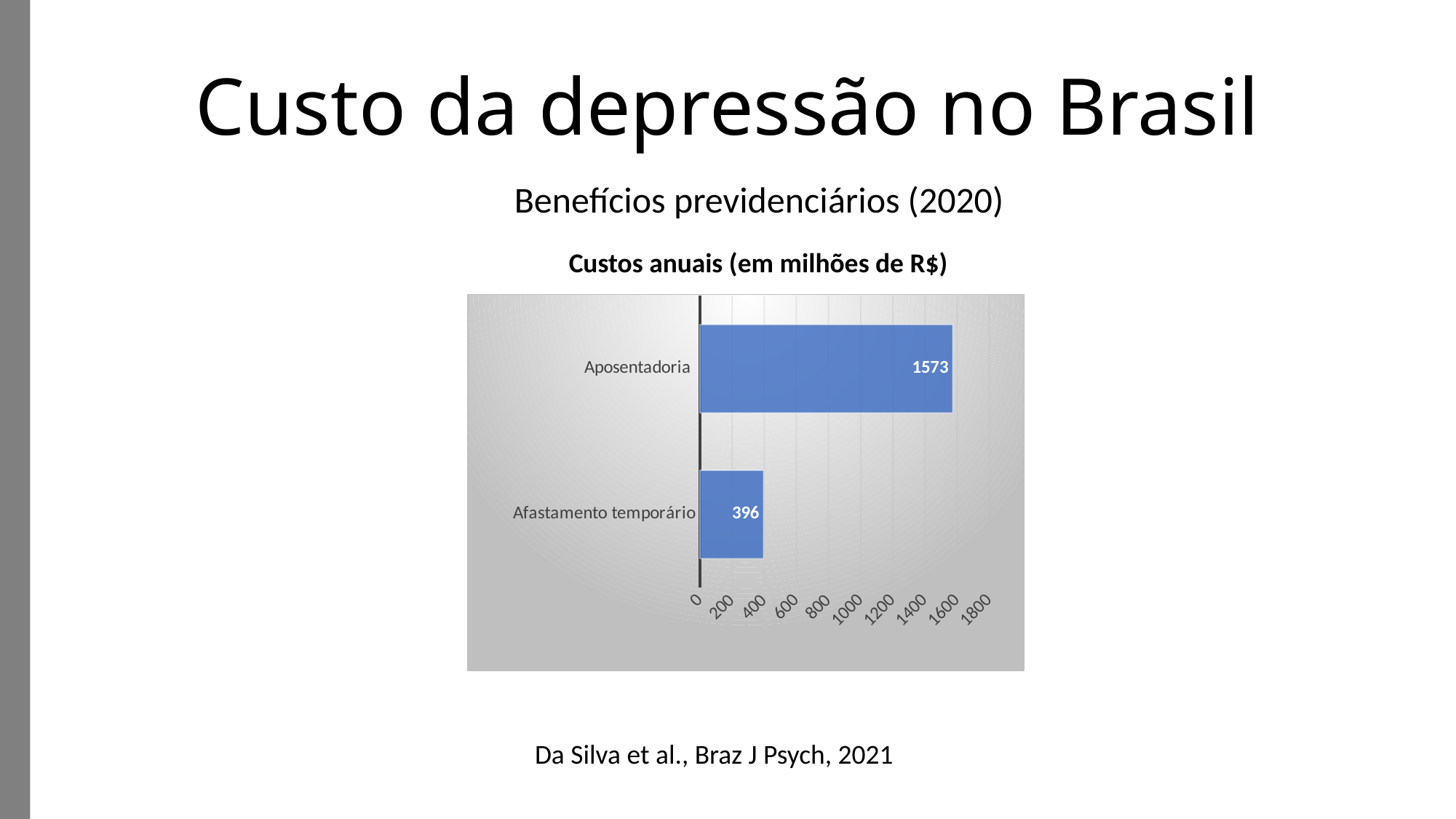
What is the difference between the values for Aposentadoria and Afastamento temporário? 1177 What is the total of the two values shown in the chart? 1969 Is the value for Aposentadoria greater or less than 1400? greater What kind of chart is shown on the slide? Bar chart How many categories are shown in the chart? 2 Which category has the highest value? Aposentadoria What is the title of the chart? Custos anuais (em milhões de R$) Which category has the lowest value? Afastamento temporário What is the value for Afastamento temporário? 396 Is the value for Afastamento temporário greater or less than 400? less Which is larger, the value for Aposentadoria or the value for Afastamento temporário? Aposentadoria What is the value for Aposentadoria? 1573